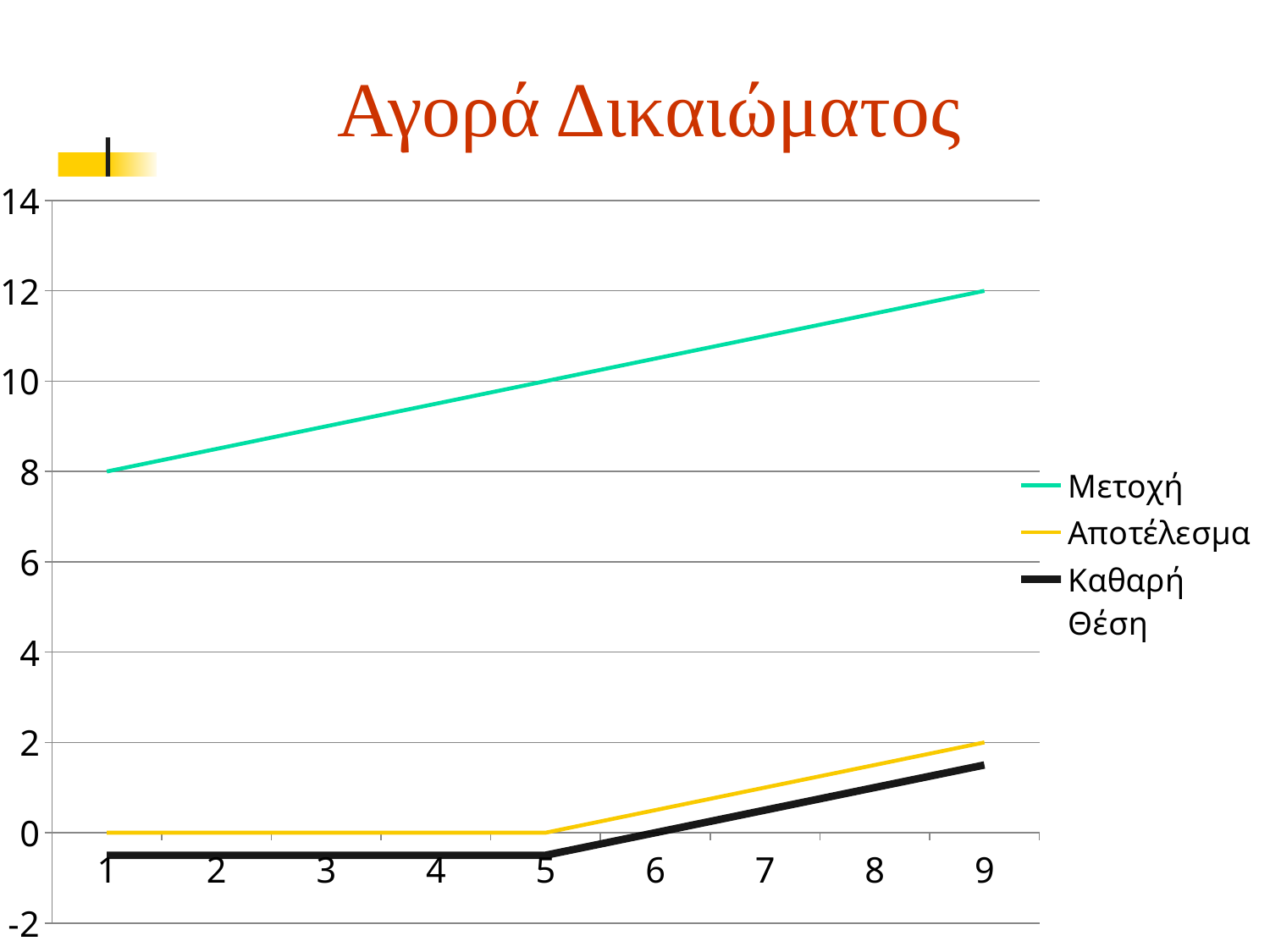
What is the value of Μετοχή at x = 9? 12 What is the value of Αποτέλεσμα at x = 1? 0 Which series has the highest values across the chart? Μετοχή How many series does the legend list? 3 Which series has the lowest value at x = 1? Καθαρή Θέση Is the value of Καθαρή Θέση at x = 9 greater or less than 2? less Does the Μετοχή line rise or fall from x = 1 to x = 9? rise What is the value of Αποτέλεσμα at x = 9? 2 How many points are on the x axis? 9 What kind of chart is shown on the slide? line chart What is the value of Μετοχή at x = 1? 8 What is the title of the chart? Αγορά Δικαιώματος